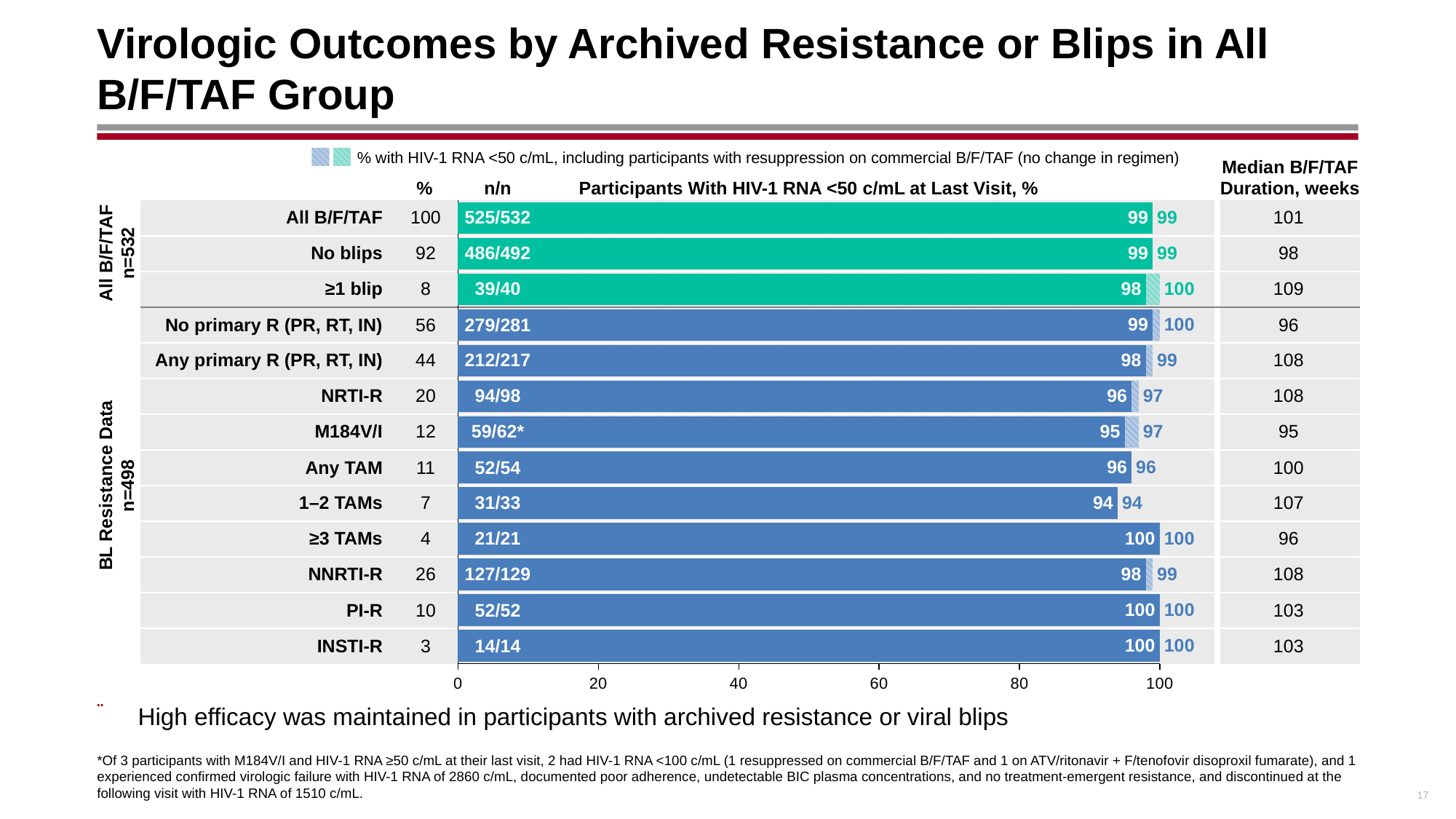
What percentage of participants with M184V/I had HIV-1 RNA <50 c/mL at last visit? 95 What is the n/n value shown for the NRTI-R category? 94/98 Is the value for Any TAM greater or less than 80? greater What is the median B/F/TAF duration in weeks for the ≥1 blip group? 109 What is the n/n value shown for All B/F/TAF? 525/532 What is the percentage with HIV-1 RNA <50 c/mL including participants with resuppression on commercial B/F/TAF for M184V/I? 97 Which has a higher percentage with HIV-1 RNA <50 c/mL at last visit, NRTI-R or 1–2 TAMs? NRTI-R What is the difference in percentage with HIV-1 RNA <50 c/mL at last visit between No primary R (PR, RT, IN) and 1–2 TAMs? 5 What is the highest tick value shown on the x axis? 100 What kind of chart is shown on the slide? bar chart Which category has the lowest percentage of participants with HIV-1 RNA <50 c/mL at last visit? 1–2 TAMs How many categories (bars) are plotted in the chart? 13